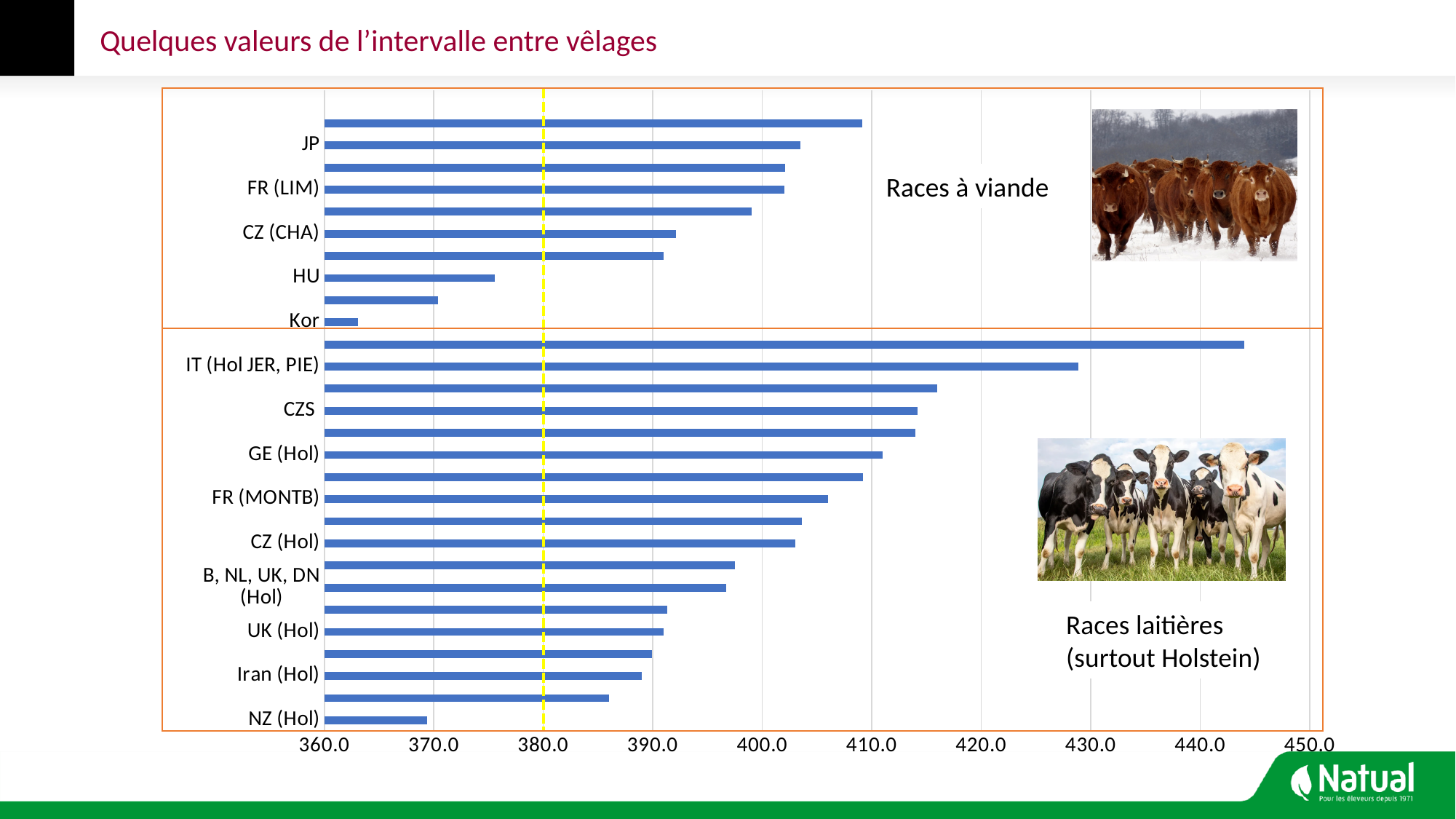
Which category has the shortest bar in the chart? Kor Is the value for NZ (Hol) greater or less than 380.0? less Is the value for CZ (CHA) greater or less than 400.0? less Is the value for Kor greater or less than 370.0? less At which x-axis value is the dashed yellow vertical line drawn? 380.0 Which has the larger value, IT (Hol JER, PIE) or JP? IT (Hol JER, PIE) What kind of chart is shown on the slide? bar chart Which has the larger value, HU or Kor? HU